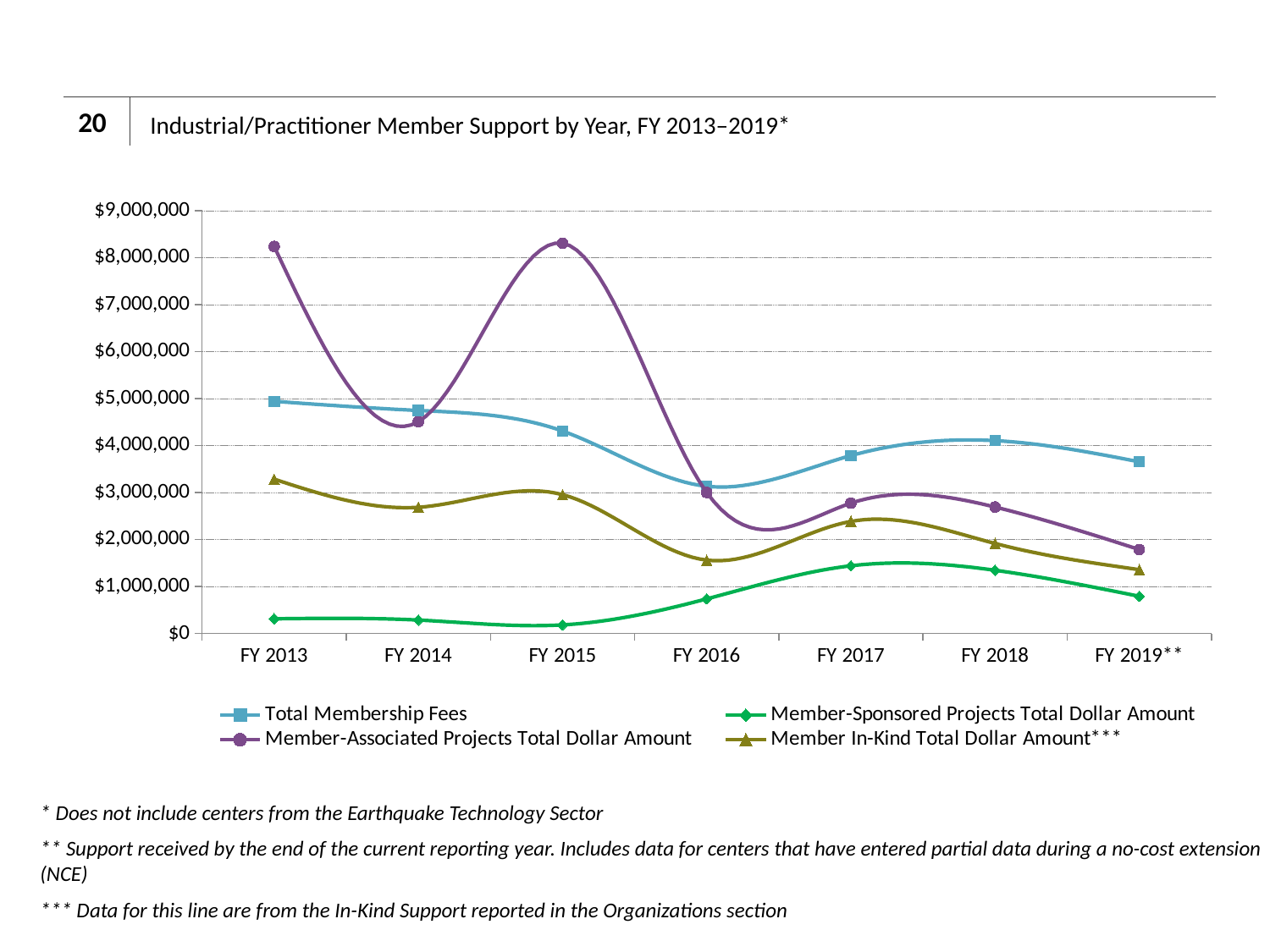
Is the value for Member-Associated Projects Total Dollar Amount in FY 2013 greater or less than $8,000,000? greater Is the value for Total Membership Fees in FY 2016 greater or less than $4,000,000? less In FY 2017, which is larger: Total Membership Fees or Member In-Kind Total Dollar Amount? Total Membership Fees Which series has the highest value in FY 2019? Total Membership Fees In which fiscal year is Total Membership Fees lowest? FY 2016 What kind of chart is shown on the slide? Line chart What is the title of the chart? Industrial/Practitioner Member Support by Year, FY 2013–2019* Is the value for Member In-Kind Total Dollar Amount in FY 2016 greater or less than $2,000,000? less How many fiscal years are plotted on the x axis? 7 In which fiscal year is Member-Sponsored Projects Total Dollar Amount lowest? FY 2015 Does Member-Associated Projects Total Dollar Amount rise or fall from FY 2015 to FY 2019? Fall How many series does the legend list? 4